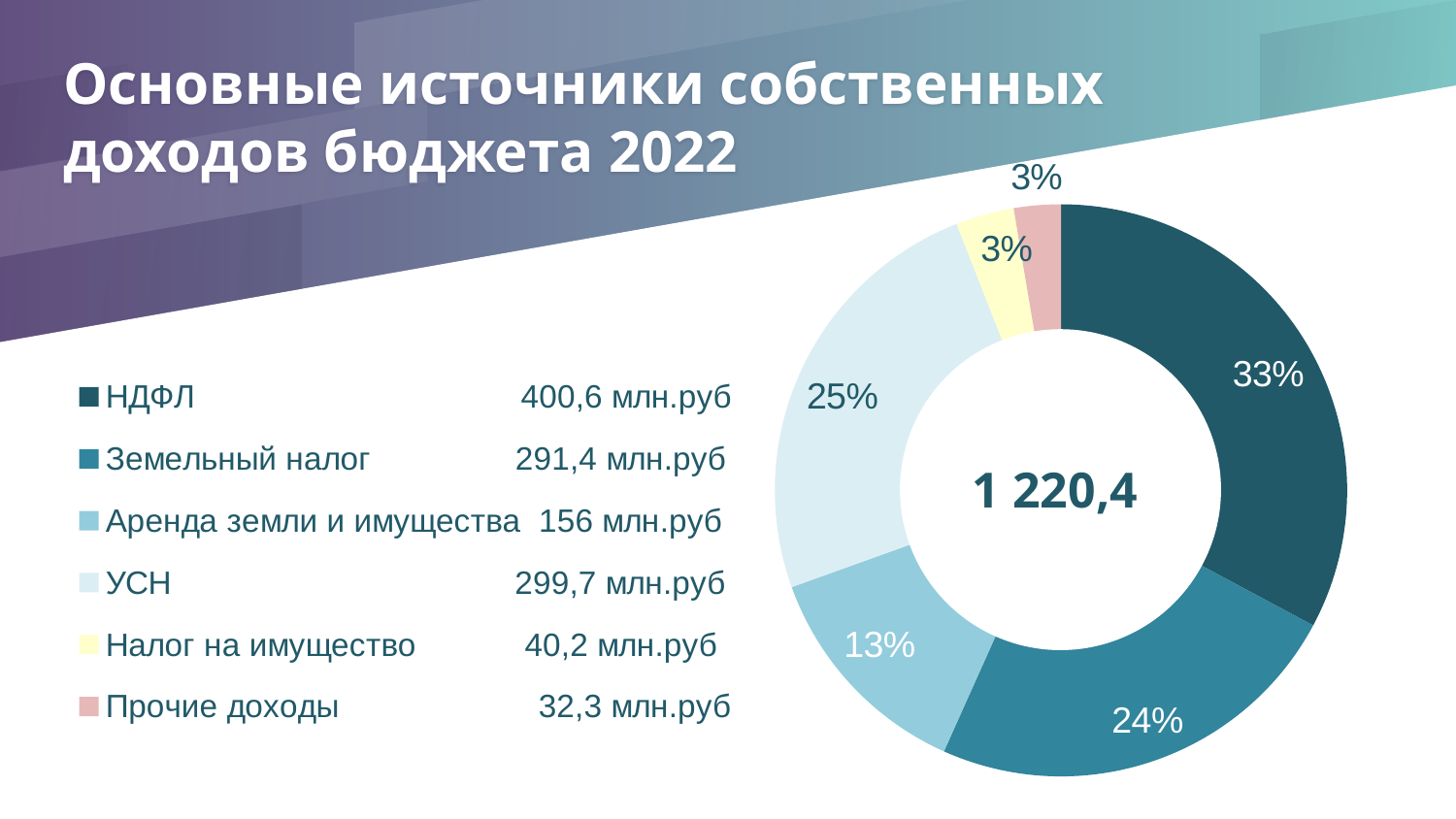
How many categories does the chart show? 6 Which category has the largest value? НДФЛ What share of the chart does Аренда земли и имущества account for? 13% Which is larger, the value for УСН or the value for Земельный налог? УСН What kind of chart is shown on the slide? Doughnut (pie) chart What is the difference between the values for НДФЛ and Земельный налог? 109,2 млн.руб What share of the chart does НДФЛ account for? 33% Which category has the smallest value? Прочие доходы What is the value shown for Налог на имущество? 40,2 млн.руб What share of the chart does УСН account for? 25% What is the value shown for Земельный налог? 291,4 млн.руб What total is shown in the centre of the chart? 1 220,4